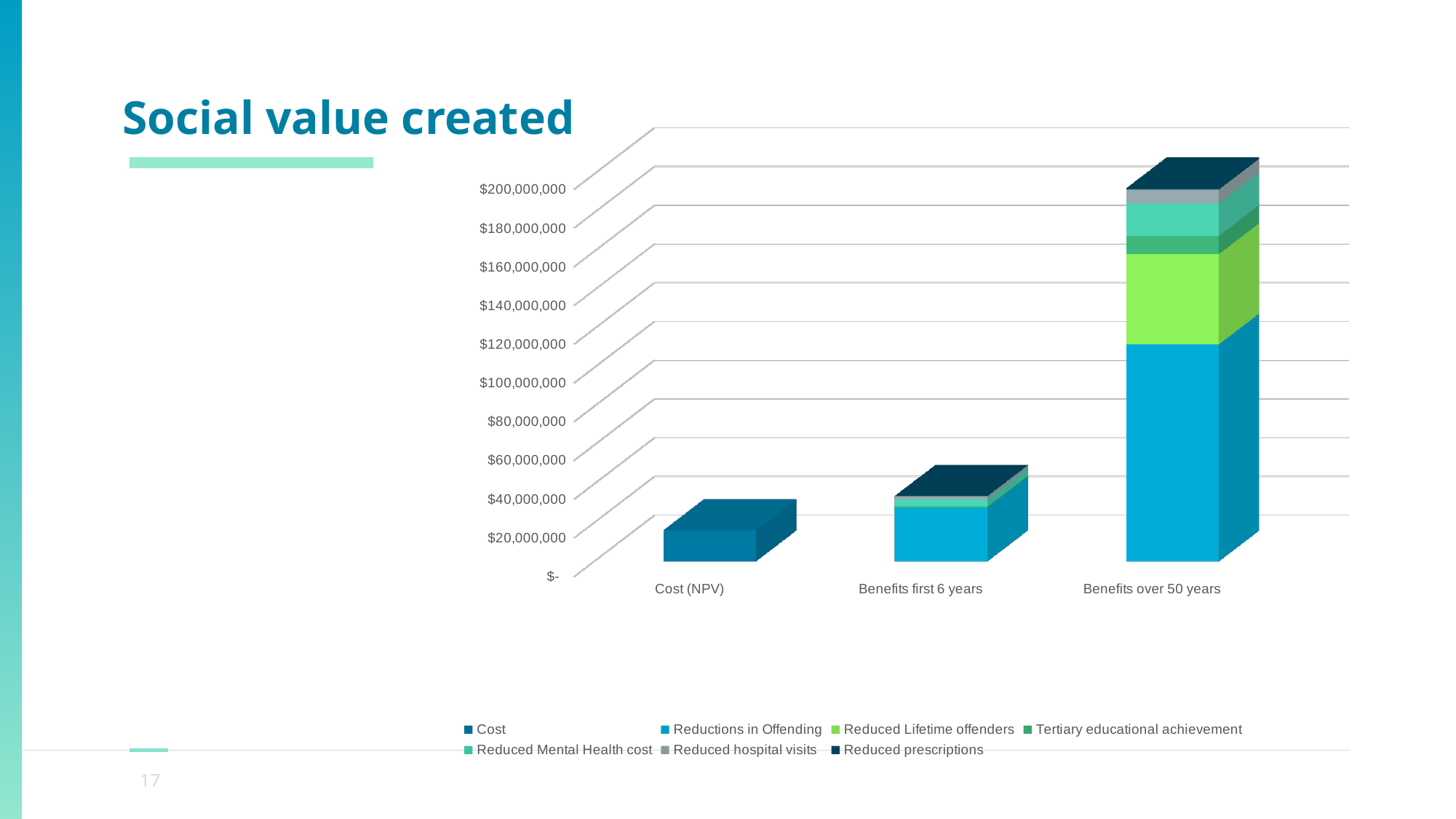
Which category has the tallest stacked bar? Benefits over 50 years What is the title of the chart? Social value created Is the value for Cost (NPV) greater or less than $40,000,000? less Is the total value for Benefits first 6 years greater or less than $80,000,000? less Do the bar totals rise or fall from left to right across the x axis? rise Is the total value for Benefits over 50 years greater or less than $160,000,000? greater Which is larger, the bar for Benefits first 6 years or the bar for Cost (NPV)? Benefits first 6 years What type of chart is shown on the slide? Stacked bar chart Which category has the shortest bar? Cost (NPV) How many categories are shown on the x axis? 3 How many series does the legend list? 7